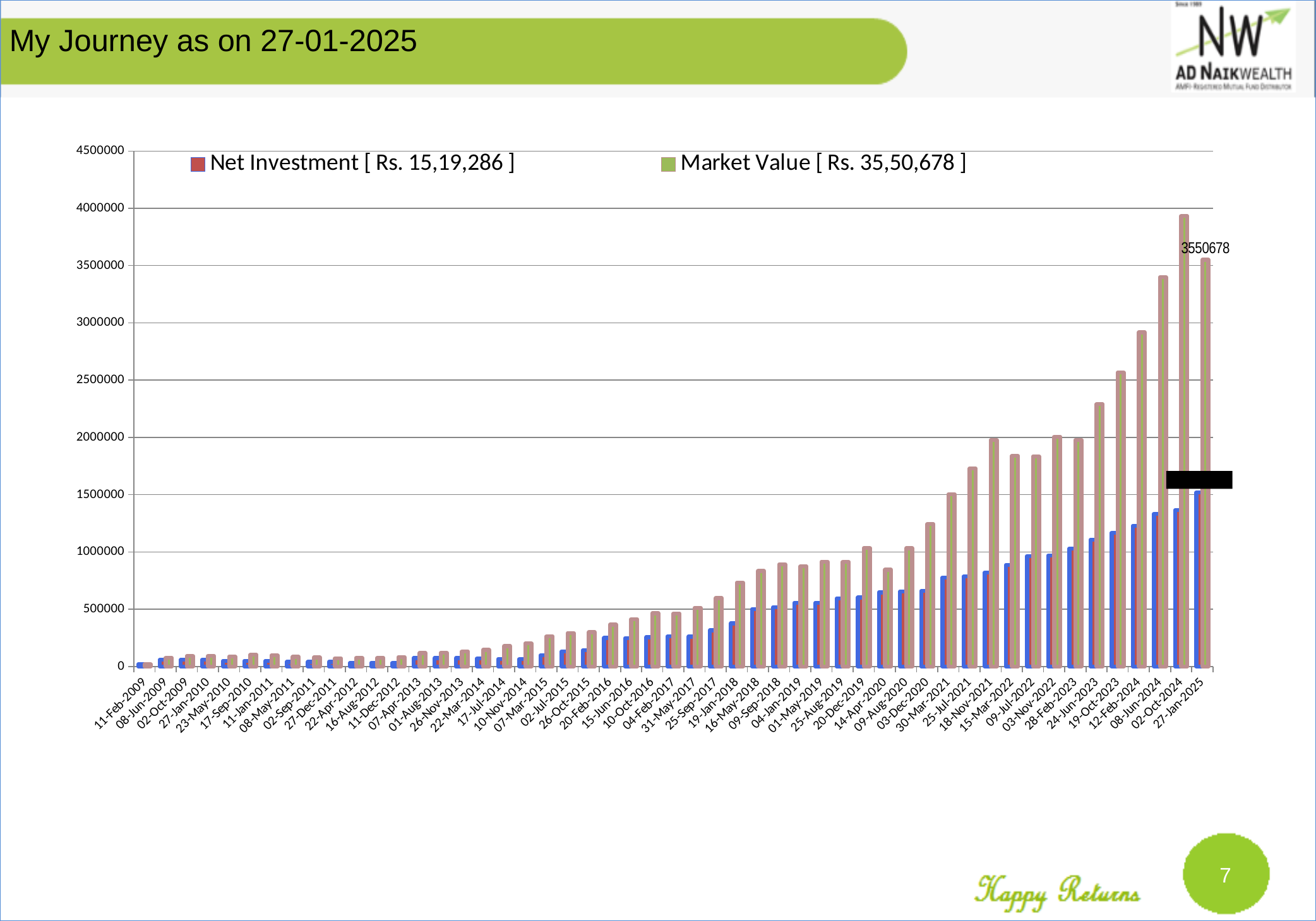
Is the Market Value for 12-Feb-2024 greater or less than 3000000? less On which date is the Market Value bar the highest? 02-Oct-2024 Is the Market Value for 19-Oct-2023 greater or less than 2500000? greater What Net Investment amount is shown in the legend entry? Rs. 15,19,286 For 27-Jan-2025, which is larger: Net Investment or Market Value? Market Value What is the Market Value shown by the data label for 27-Jan-2025? 3550678 How many series does the chart legend list? 2 What type of chart is shown on the slide? bar chart What Market Value amount is shown in the legend entry? Rs. 35,50,678 Is the Market Value for 02-Oct-2024 greater or less than 3500000? greater Does the Net Investment generally rise or fall from 11-Feb-2009 to 27-Jan-2025? rise